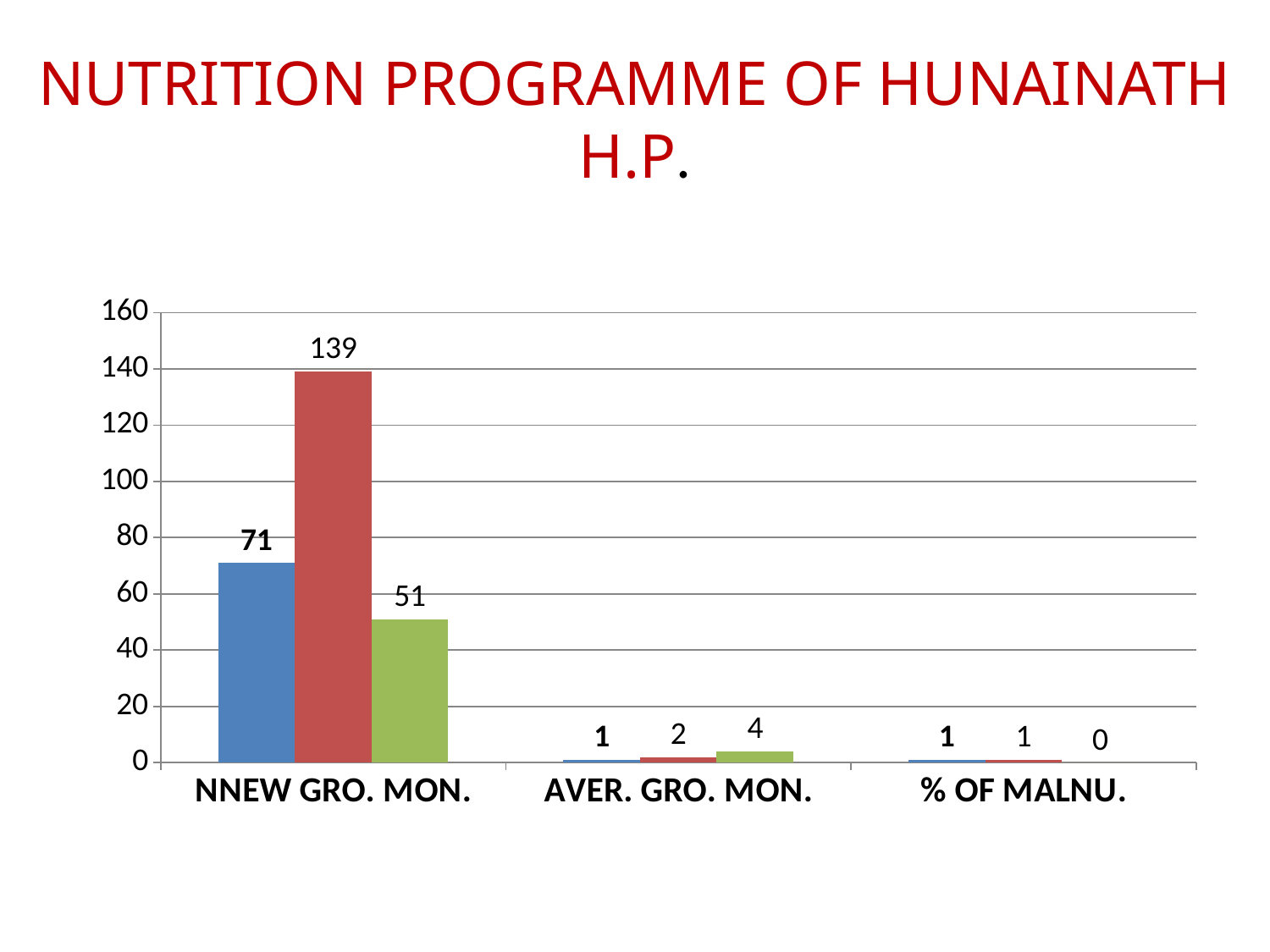
How many categories are shown on the x axis? 3 Which category has the lowest green bar? % OF MALNU. What kind of chart is shown on the slide? bar chart What is the difference between the red bar and the blue bar for NNEW GRO. MON.? 68 What is the value of the blue bar for NNEW GRO. MON.? 71 What is the value of the green bar for % OF MALNU.? 0 What is the title of the slide? NUTRITION PROGRAMME OF HUNAINATH H.P. What is the value of the green bar for NNEW GRO. MON.? 51 What is the value of the red bar for NNEW GRO. MON.? 139 What is the value of the green bar for AVER. GRO. MON.? 4 Which category has the highest red bar? NNEW GRO. MON. For NNEW GRO. MON., which is larger, the blue bar or the green bar? the blue bar